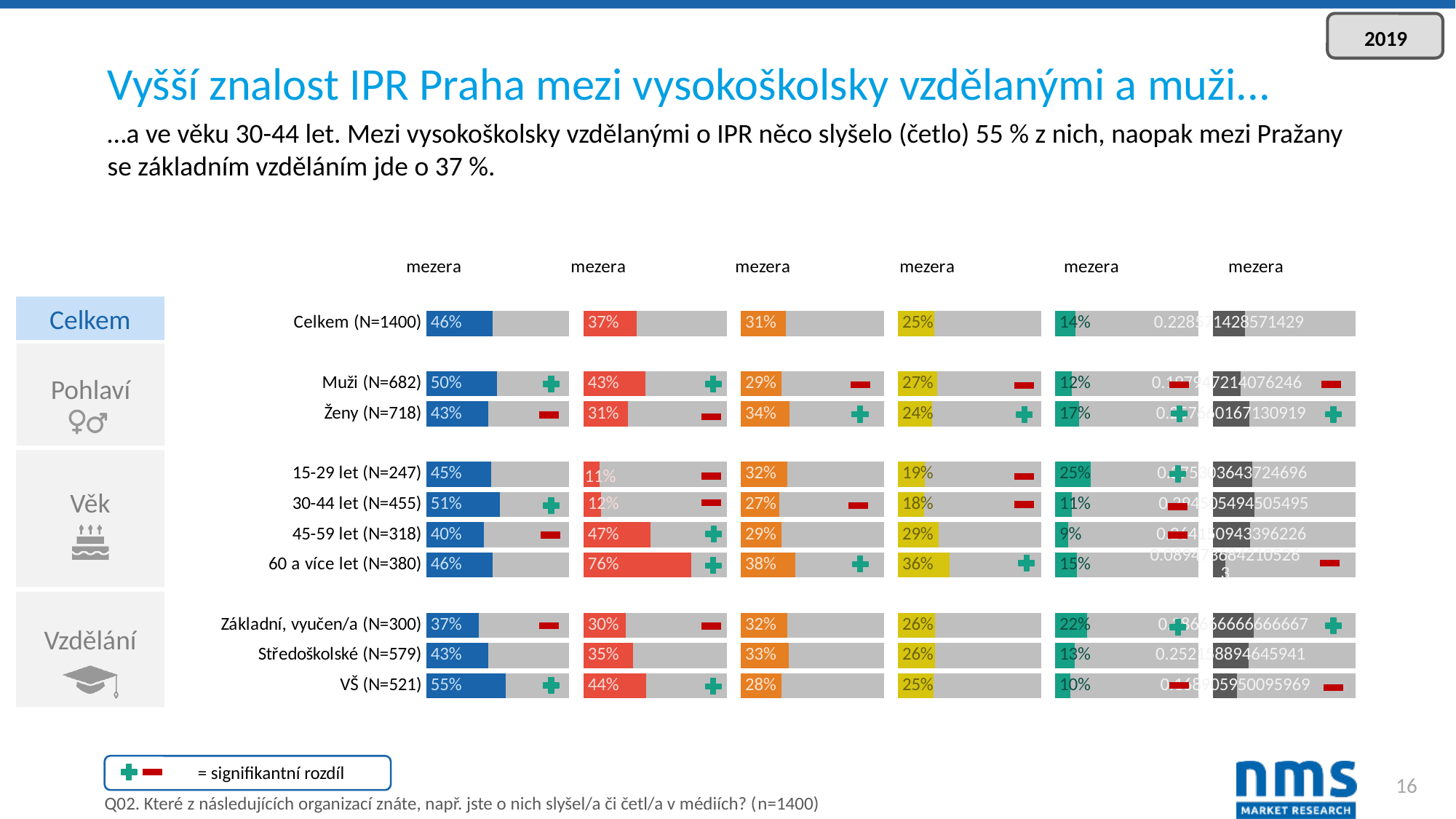
In the fourth (yellow) bar chart from the left, what is the value for 60 a více let (N=380)? 36% In the second (red) bar chart from the left, what is the value for 60 a více let (N=380)? 76% In the leftmost (blue) bar chart, what is the value for VŠ (N=521)? 55% How many categories (rows) does the leftmost (blue) bar chart show? 10 In the fifth (green) bar chart from the left, what is the value for 15-29 let (N=247)? 25% In the leftmost (blue) bar chart, what is the value for Celkem (N=1400)? 46% In the second (red) bar chart from the left, which category has the lowest value? 15-29 let (N=247) In the leftmost (blue) bar chart, what is the difference between the values for VŠ (N=521) and Základní, vyučen/a (N=300)? 18% In the leftmost (blue) bar chart, which category has the highest value? VŠ (N=521) In the third (orange) bar chart from the left, which is larger: the value for Muži (N=682) or Ženy (N=718)? Ženy (N=718) What type of chart is used for the leftmost (blue) chart on the slide? Bar chart In the fifth (green) bar chart from the left, which category has the lowest value? 45-59 let (N=318)